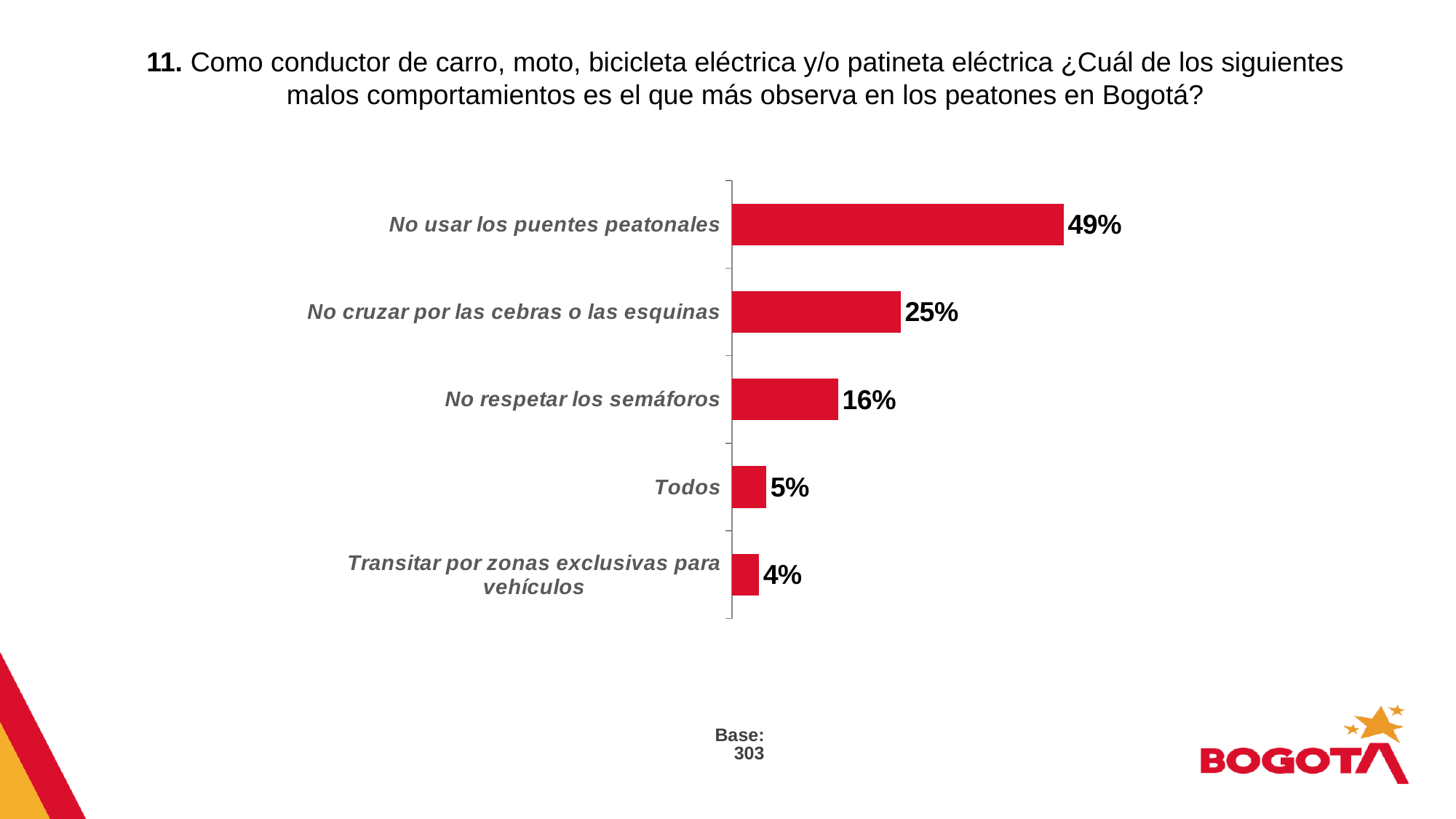
What is the difference in percentage points between "No usar los puentes peatonales" and "No cruzar por las cebras o las esquinas"? 24 What percentage is shown for "No usar los puentes peatonales"? 49% How many categories are shown in the chart? 5 What colour are the bars in the chart? Red What is the base (number of respondents) shown below the chart? 303 What kind of chart is shown on the slide? Bar chart What percentage is shown for "Transitar por zonas exclusivas para vehículos"? 4% Which category has the highest percentage? No usar los puentes peatonales What percentage is shown for "No cruzar por las cebras o las esquinas"? 25% Which category has the lowest percentage? Transitar por zonas exclusivas para vehículos Which is larger, the value for "No respetar los semáforos" or the value for "Todos"? No respetar los semáforos What percentage is shown for "No respetar los semáforos"? 16%